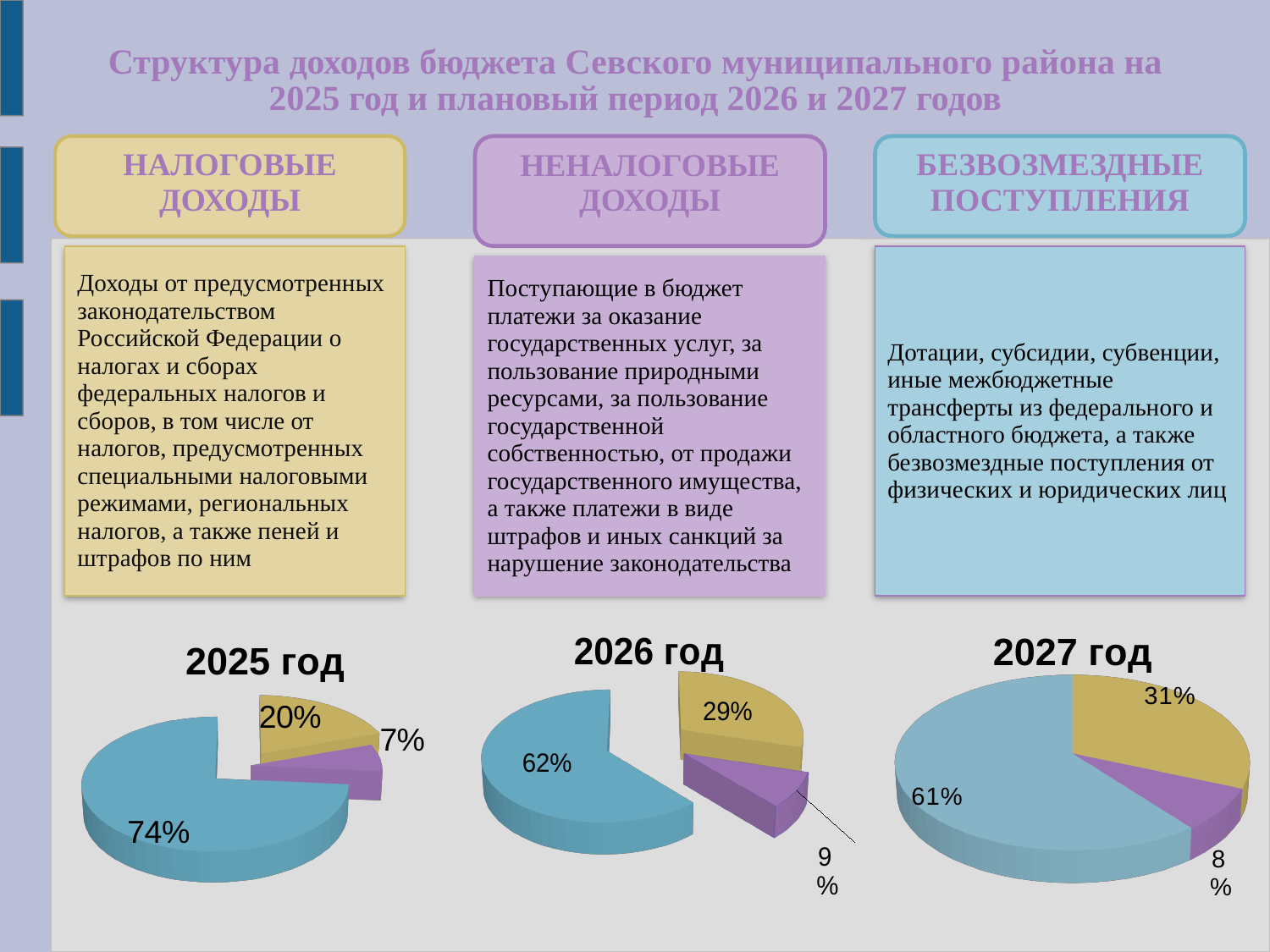
In the "2025 год" pie chart, what is the value of the largest slice? 74% How many pie charts are on the slide? 3 In the "2026 год" pie chart, what is the value of the yellow slice? 29% In the "2026 год" pie chart, what is the value of the purple slice? 9% Which is larger: the yellow slice in the "2025 год" chart or the yellow slice in the "2027 год" chart? 2027 год In the "2026 год" pie chart, what is the difference between the blue slice and the yellow slice? 33 percentage points In the "2025 год" pie chart, what is the value of the yellow slice? 20% In the "2027 год" pie chart, what is the value of the purple slice? 8% In the "2025 год" pie chart, what is the value of the smallest slice? 7% How many slices does each pie chart have? 3 In the "2027 год" pie chart, what is the value of the blue slice? 61% What kind of charts are shown at the bottom of the slide? Pie charts